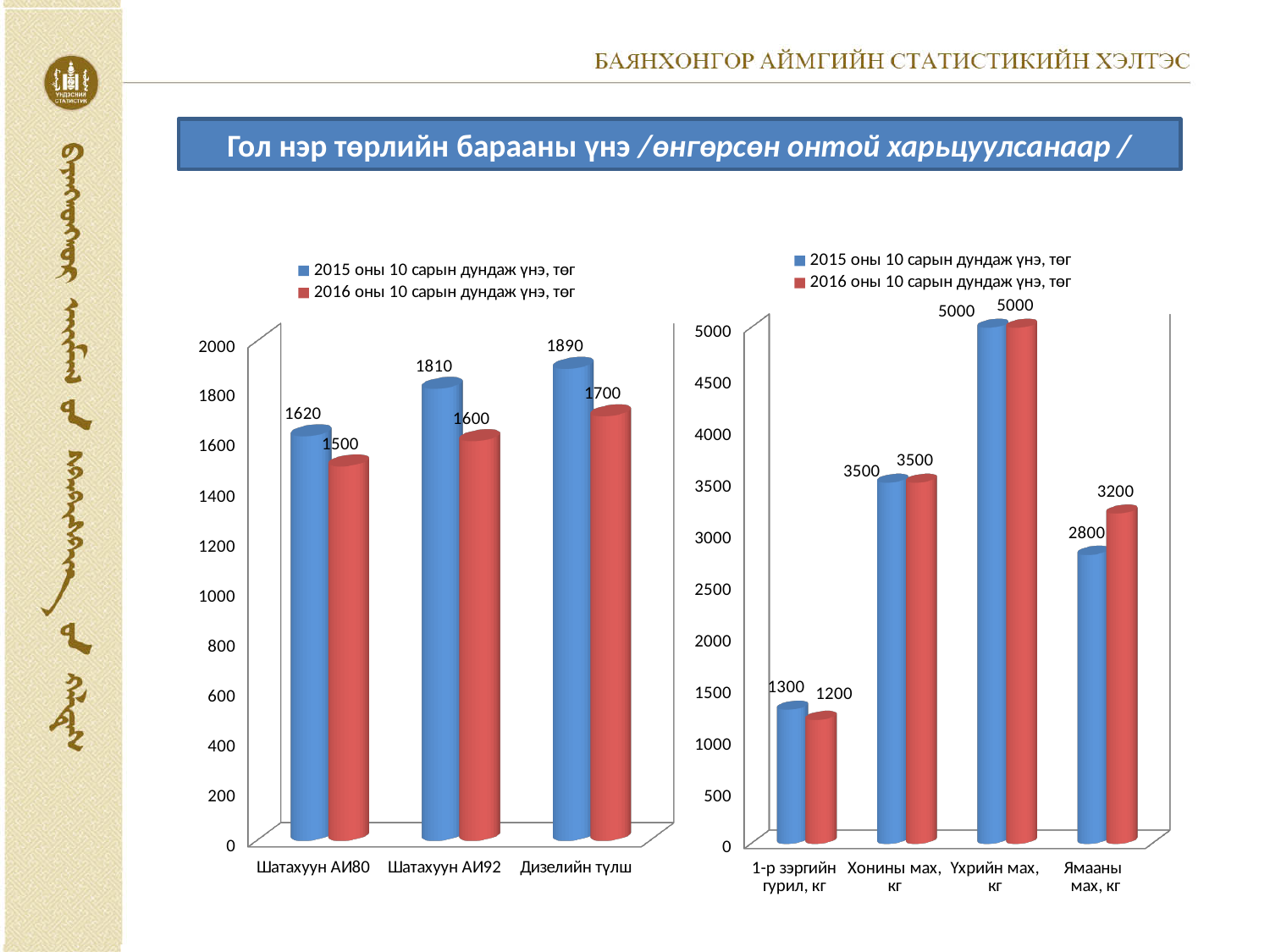
How many series does the legend of the left chart list? 2 In the left chart, what is the 2016 оны 10 сарын дундаж үнэ for Дизелийн түлш? 1700 In the right chart, which category has the lowest 2016 оны 10 сарын дундаж үнэ? 1-р зэргийн гурил, кг In the left chart, which category has the highest 2015 оны 10 сарын дундаж үнэ? Дизелийн түлш In the right chart, what is the 2016 оны 10 сарын дундаж үнэ for Ямааны мах, кг? 3200 In the right chart, what is the 2015 оны 10 сарын дундаж үнэ for 1-р зэргийн гурил, кг? 1300 In the left chart, what is the 2015 оны 10 сарын дундаж үнэ for Шатахуун АИ92? 1810 In the left chart, what is the difference between the 2015 and 2016 values for Шатахуун АИ92? 210 What type of chart is the left chart? Bar chart How many categories are shown in the right chart? 4 In the right chart, what is the difference between the 2016 and 2015 values for Ямааны мах, кг? 400 In the right chart, which is larger for Ямааны мах, кг: the 2015 value or the 2016 value? 2016 value